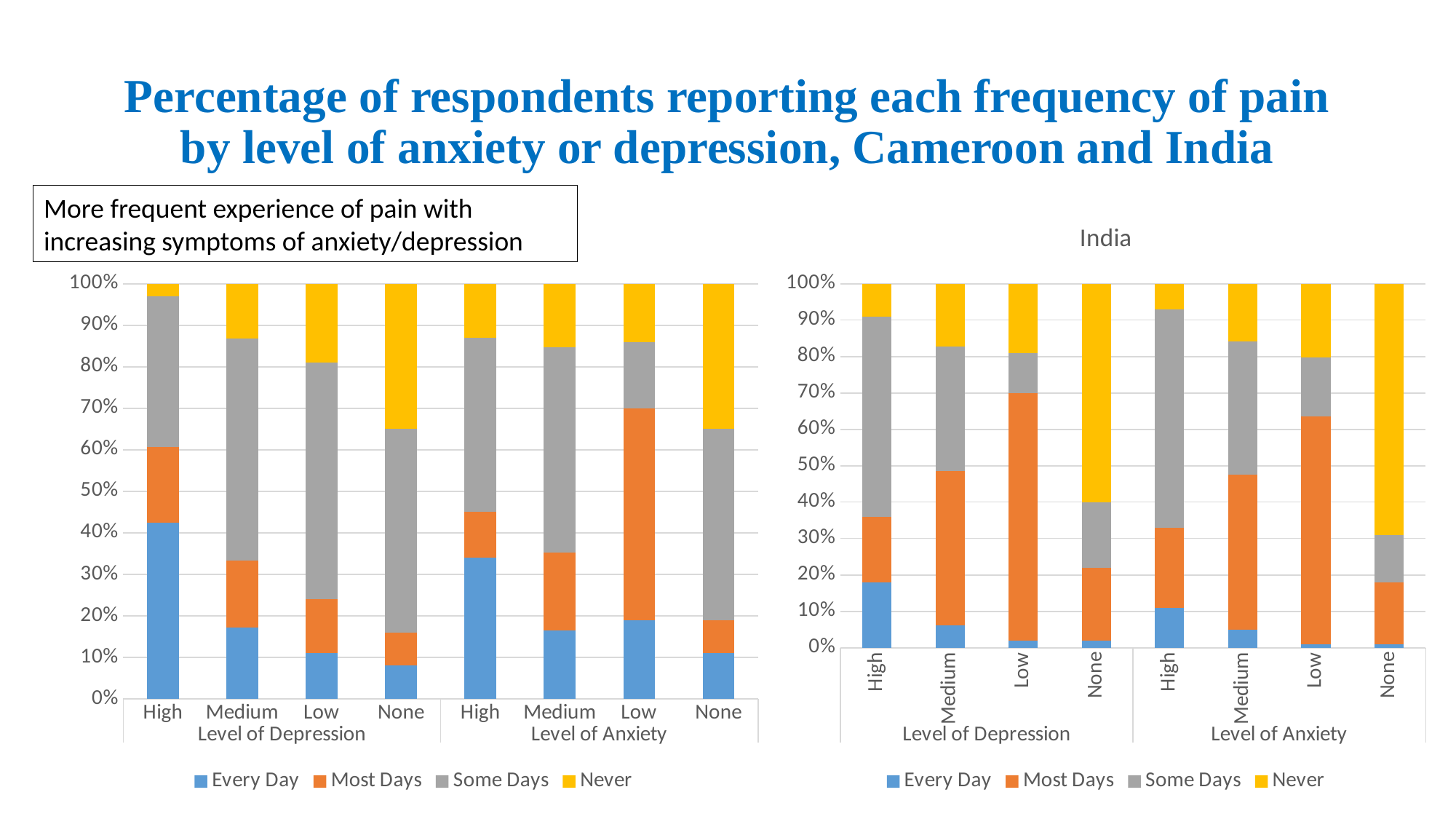
In the India chart, is the Every Day value for Low under Level of Depression greater or less than 10%? less What is the total of the stacked bar for None under Level of Anxiety in the India chart? 100% In the left chart, is the Every Day value for None under Level of Anxiety greater or less than 20%? less What kind of chart is the left chart? stacked bar chart In the left chart, does the Every Day share rise or fall from High to None under Level of Depression? fall In the left chart, is the Every Day value for High under Level of Depression greater or less than 30%? greater How many bars are plotted in the left chart? 8 What is the title of the right chart? India In the left chart, which category has the largest Every Day segment? High (Level of Depression) In the left chart, which is larger, the Every Day value for High or for Medium under Level of Depression? High How many series does the legend of the India chart list? 4